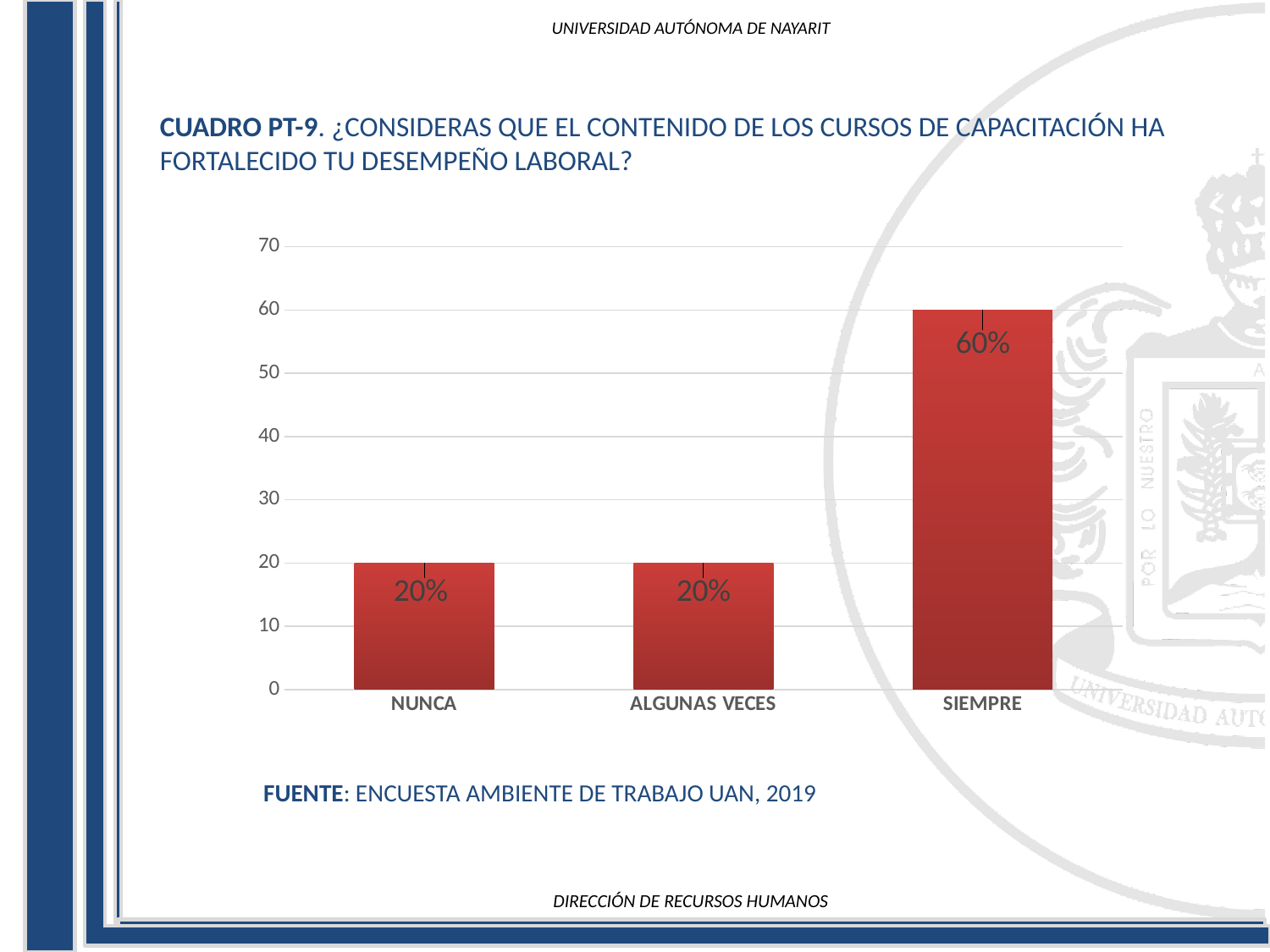
What is the source cited below the chart? ENCUESTA AMBIENTE DE TRABAJO UAN, 2019 Which category has the highest value? SIEMPRE What is the highest value shown on the y axis? 70 How many categories are shown on the x axis? 3 What is the value for NUNCA? 20% Is the value for SIEMPRE greater or less than 50? greater What is the difference between the values for SIEMPRE and NUNCA? 40% What is the value for ALGUNAS VECES? 20% Which is larger, the value for SIEMPRE or the value for ALGUNAS VECES? SIEMPRE What is the value for SIEMPRE? 60% What kind of chart is shown on the slide? bar chart Is the value for NUNCA greater or less than 30? less